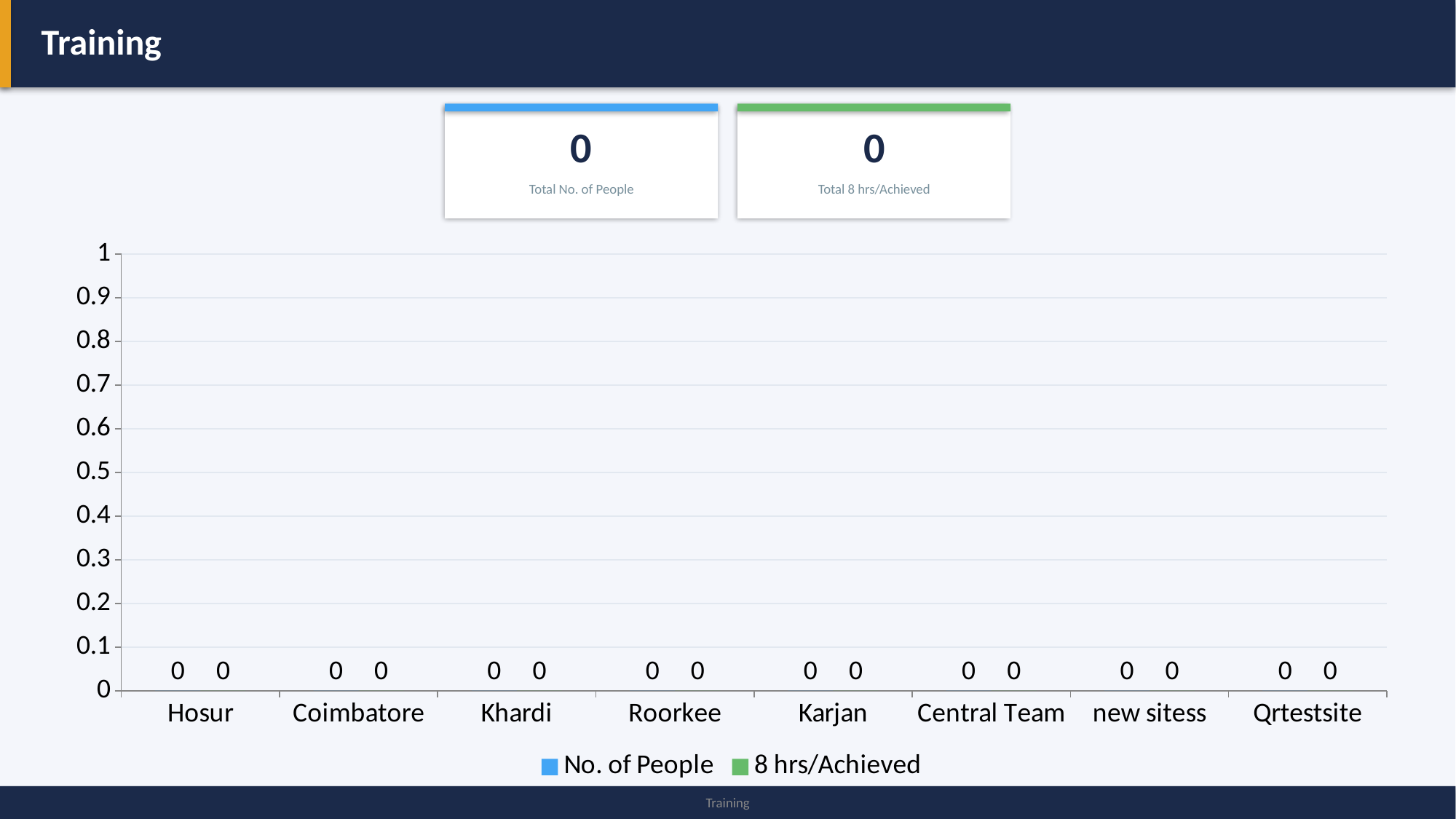
What is the value shown in the Total 8 hrs/Achieved box? 0 How many series does the chart legend list? 2 Do the No. of People values rise, fall, or stay flat across the categories? stay flat What kind of chart is shown on the slide? bar chart What is the value for 8 hrs/Achieved at Qrtestsite? 0 What is the value for 8 hrs/Achieved at Coimbatore? 0 What is the difference between No. of People and 8 hrs/Achieved at Karjan? 0 What is the value for No. of People at Hosur? 0 Which colour represents the 8 hrs/Achieved series in the legend? green What is the value for No. of People at Central Team? 0 What is the value shown in the Total No. of People box? 0 How many categories are shown on the x axis of the chart? 8